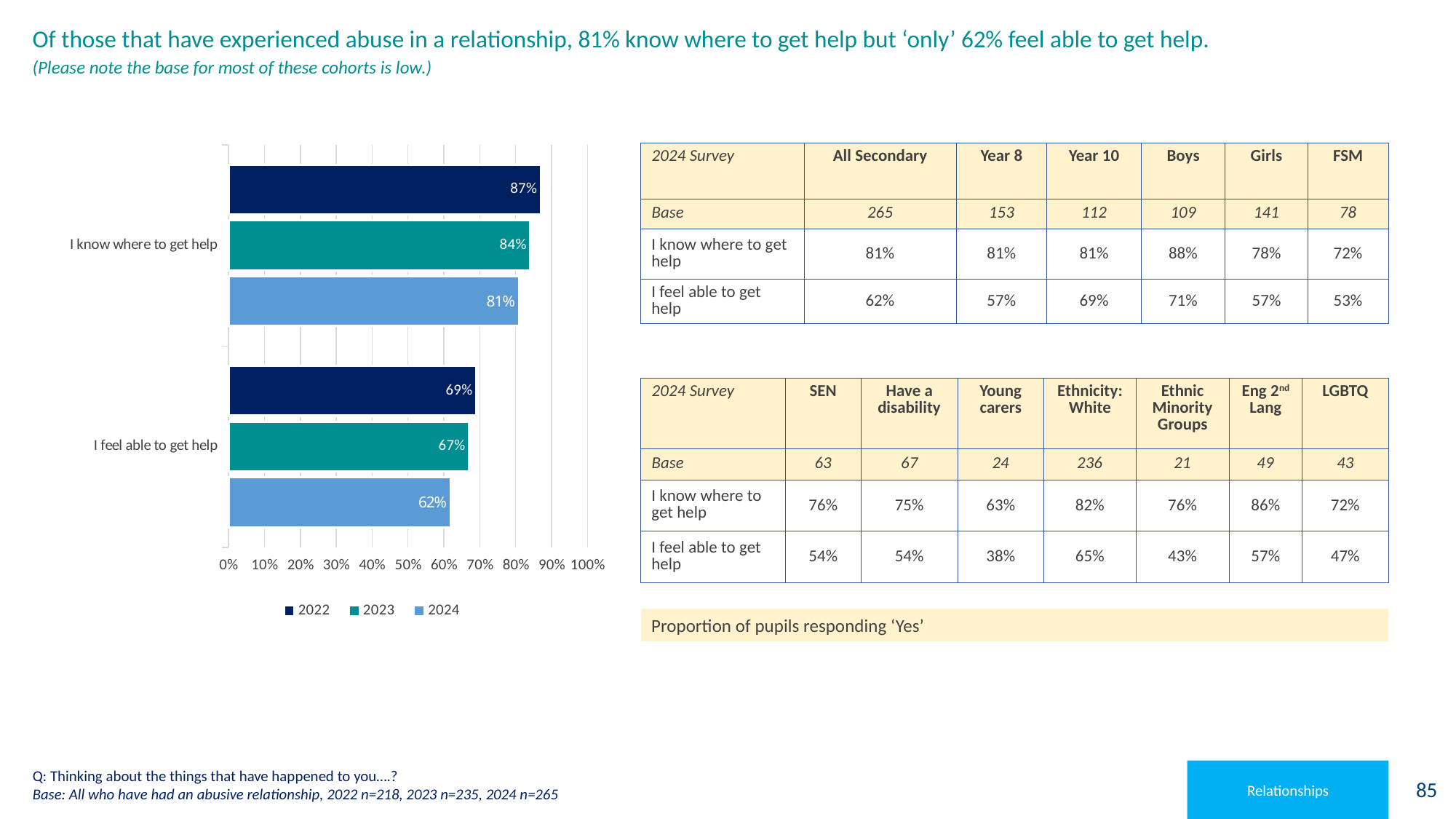
Do the values for 'I feel able to get help' rise or fall from 2022 to 2024? Fall What is the difference between the 2022 and 2024 values for 'I know where to get help'? 6% What is the 2022 value for 'I feel able to get help'? 69% What kind of chart is shown on the slide? Bar chart What is the 2023 value for 'I feel able to get help'? 67% What is the 2024 value for 'I know where to get help'? 81% Which year has the lowest value for 'I feel able to get help'? 2024 What is the difference between the 2022 and 2024 values for 'I feel able to get help'? 7% How many series does the legend list? 3 How many categories are shown on the chart? 2 Which is larger: the 2023 value for 'I know where to get help' or the 2023 value for 'I feel able to get help'? I know where to get help Which year has the highest value for 'I know where to get help'? 2022